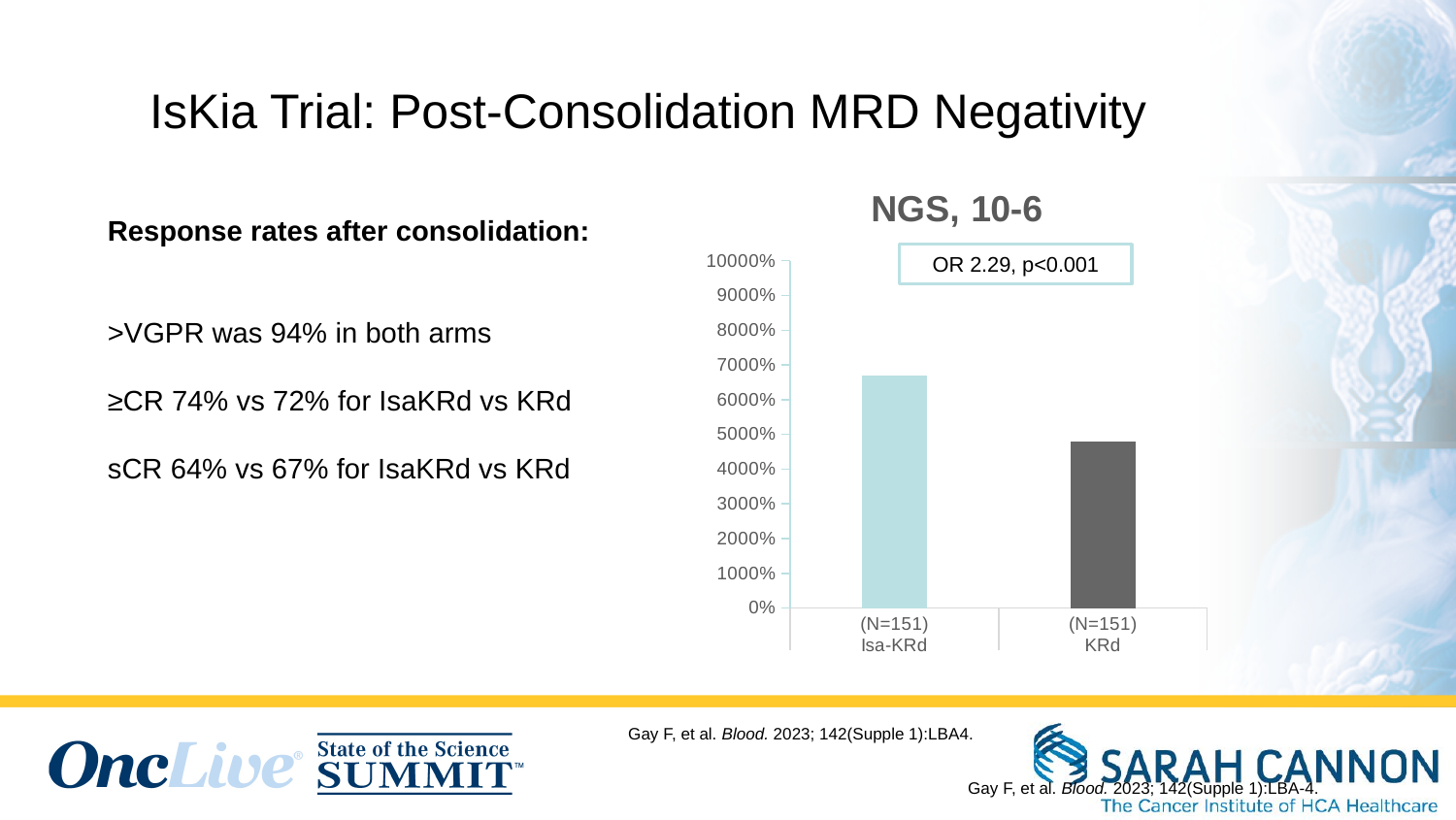
How many bars are plotted in the chart? 2 Is the value for KRd greater or less than 4000%? greater What is the sample size (N) shown for the KRd arm on the x axis? N=151 Is the bar for Isa-KRd taller or shorter than the bar for KRd? taller What odds ratio and p-value are annotated on the chart? OR 2.29, p<0.001 Which arm has the higher bar in the chart? Isa-KRd Which arm has the lower bar in the chart? KRd Is the value for Isa-KRd greater or less than 6000%? greater Is the value for Isa-KRd greater or less than 7000%? less What kind of chart is shown on the slide? bar chart What is the title of the chart? NGS, 10-6